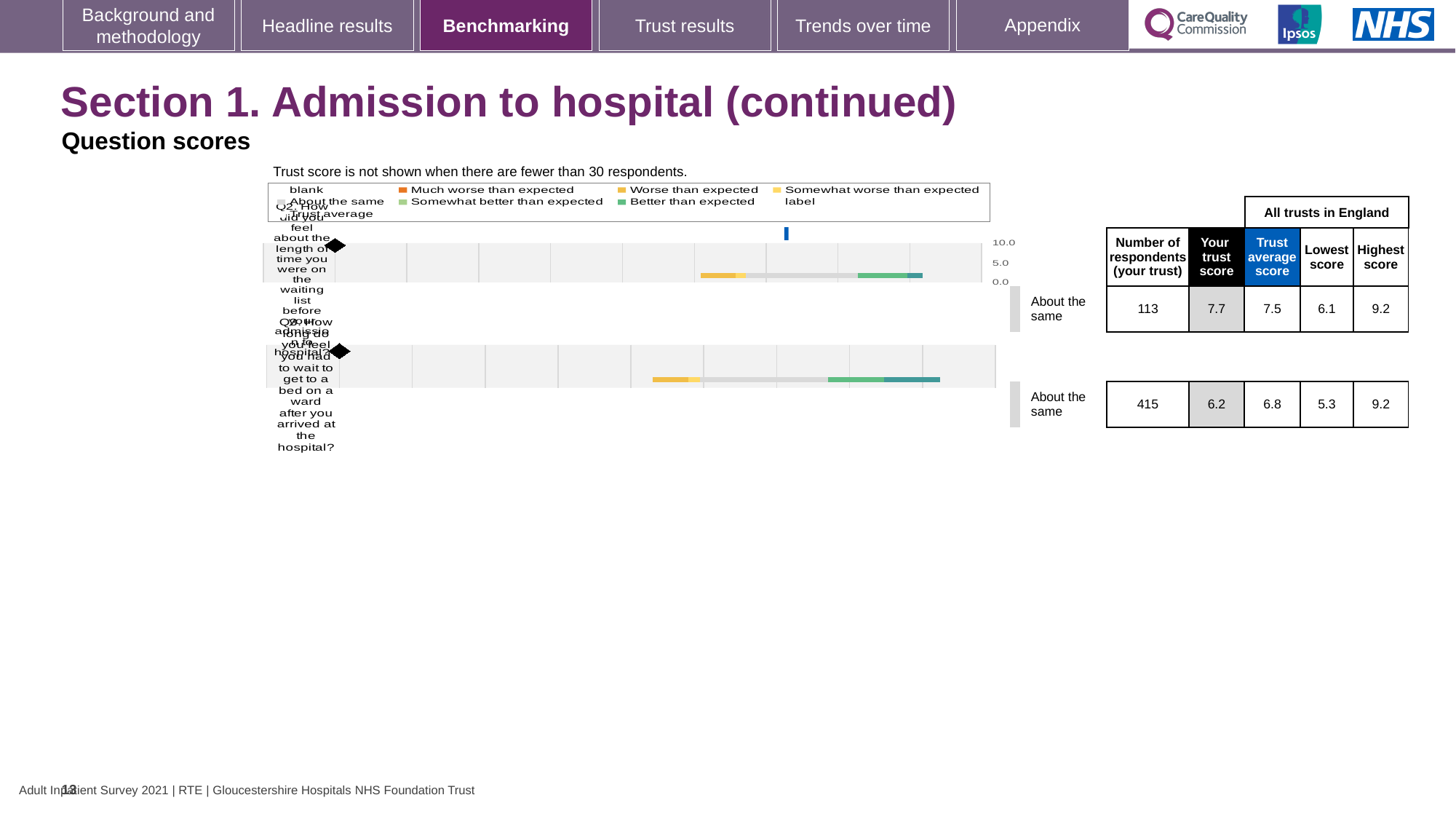
How many respondents answered Q3 at this trust? 415 By how much does the trust score for Q2 exceed the trust average score for Q2? 0.2 What is the difference between the highest and lowest scores across all trusts in England for Q3? 3.9 What is the 'Your trust score' for Q3 (how long did you feel you had to wait to get to a bed on a ward)? 6.2 What kind of chart is used to show the question scores on this slide? Bar chart What is the 'Your trust score' for Q2 (how did you feel about the length of time on the waiting list before admission)? 7.7 Is the trust score for Q2 greater or less than 5.0 on the chart axis? greater What is the lowest score among all trusts in England for Q2? 6.1 Which question has the higher 'Your trust score', Q2 or Q3? Q2 How many questions are plotted on the benchmarking chart on this slide? 2 For Q3, which is larger: the trust's own score or the trust average score for all trusts in England? Trust average score What is the trust average score across all trusts in England for Q2? 7.5